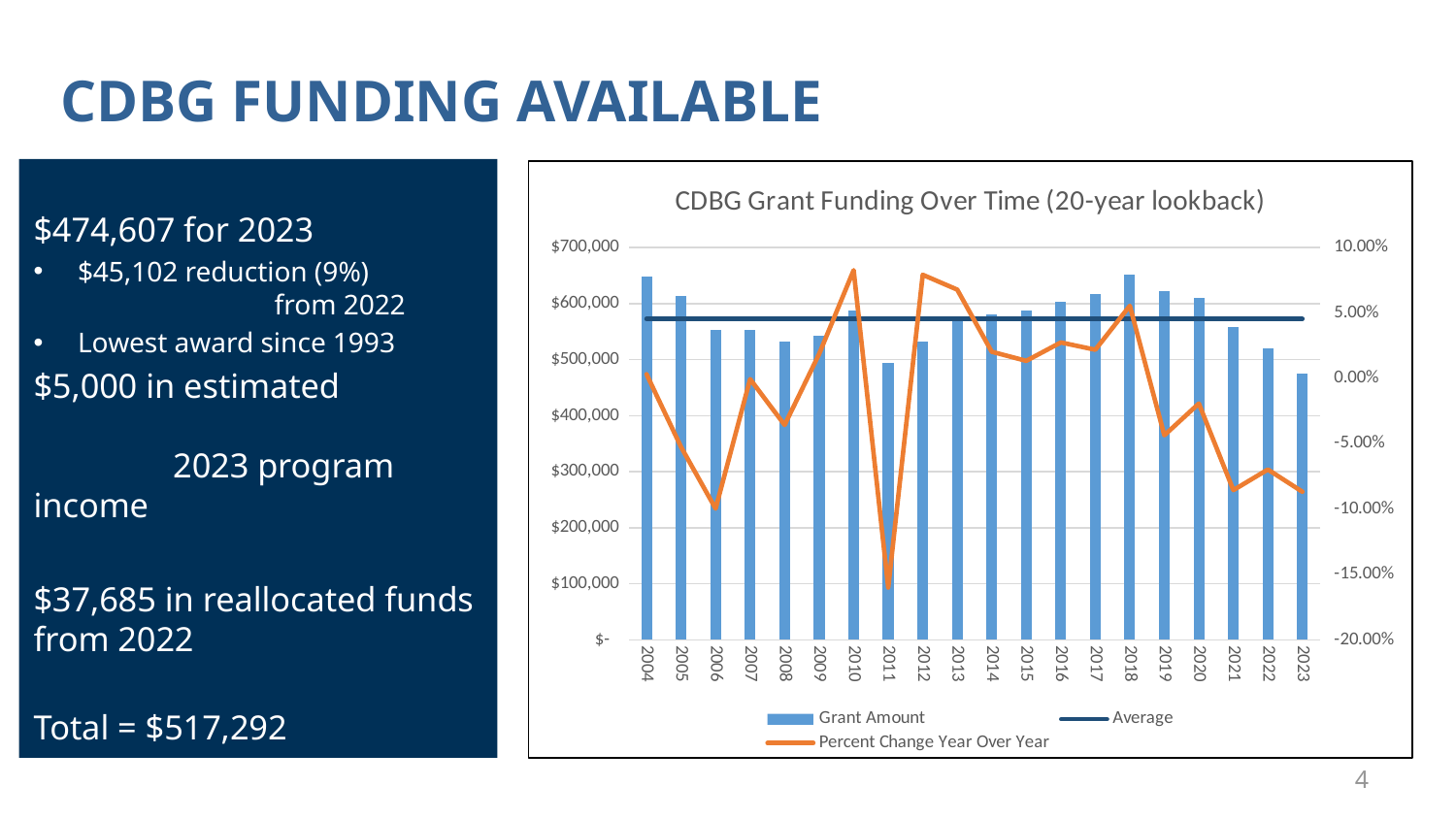
Is the Percent Change Year Over Year for 2010 greater or less than 5.00%? greater Which series is drawn as an orange line in the chart? Percent Change Year Over Year Is the Percent Change Year Over Year for 2011 greater or less than -10.00%? less Do the Grant Amount bars rise or fall from 2018 to 2023? fall Which year has the lowest Grant Amount bar? 2023 How many series does the chart legend list? 3 How many years are shown on the x axis of the chart? 20 What is the title of the chart? CDBG Grant Funding Over Time (20-year lookback) Is the Grant Amount for 2004 greater or less than $600,000? greater Which year has the larger Grant Amount, 2010 or 2011? 2010